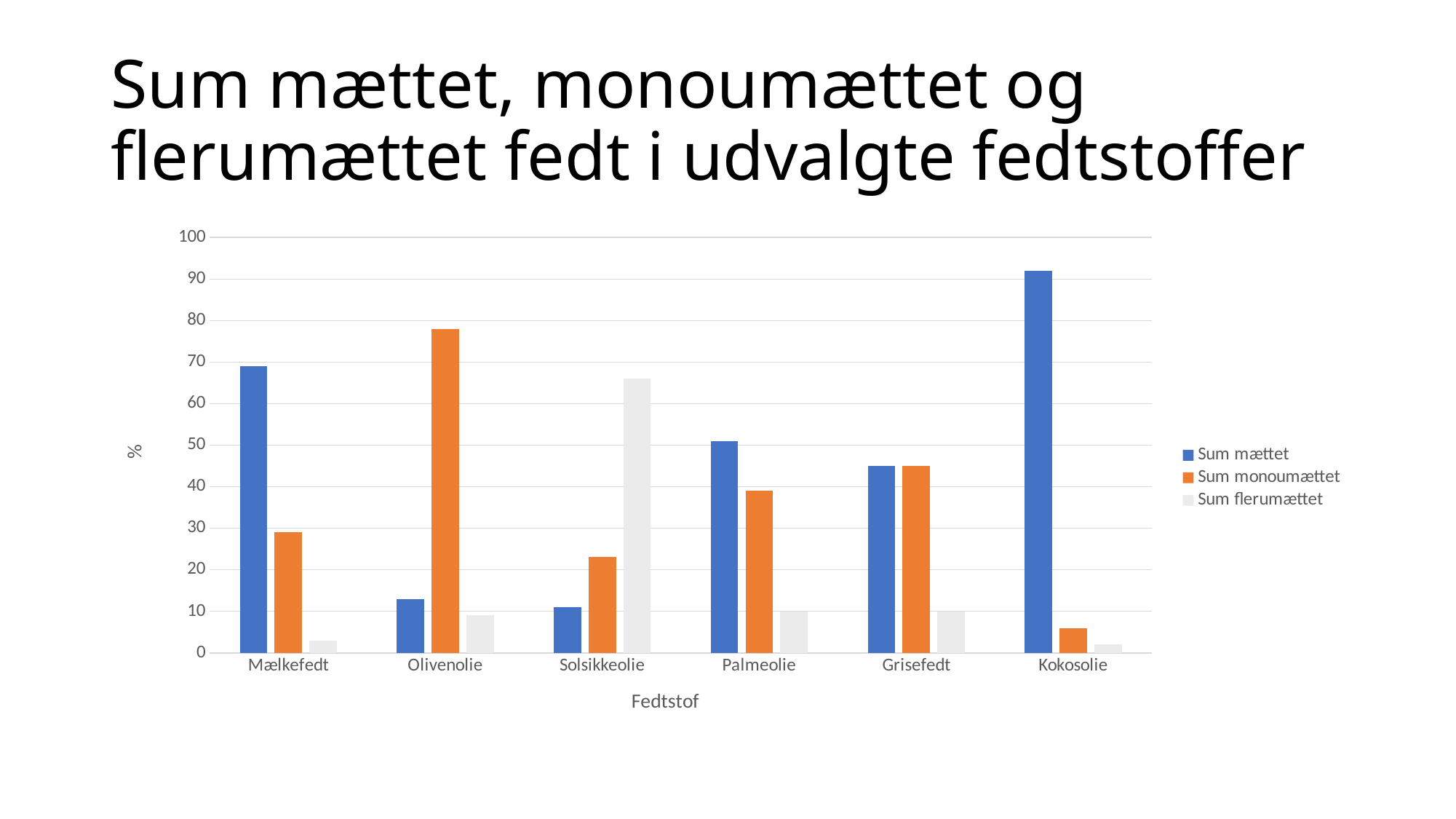
Is the Sum monoumættet value for Olivenolie greater or less than 70? greater Which fat type has the highest value for Sum monoumættet? Olivenolie How many series does the legend list? 3 What is the label on the x axis of the chart? Fedtstof Is the Sum flerumættet value for Solsikkeolie greater or less than 60? greater For Mælkefedt, which is larger: Sum mættet or Sum monoumættet? Sum mættet Which fat type has the highest value for Sum flerumættet? Solsikkeolie Which fat type has the highest value for Sum mættet? Kokosolie Is the Sum mættet value for Kokosolie greater or less than 90? greater Which fat type has the lowest value for Sum monoumættet? Kokosolie What kind of chart is shown on the slide? Bar chart How many fat types (categories) are shown on the x axis? 6